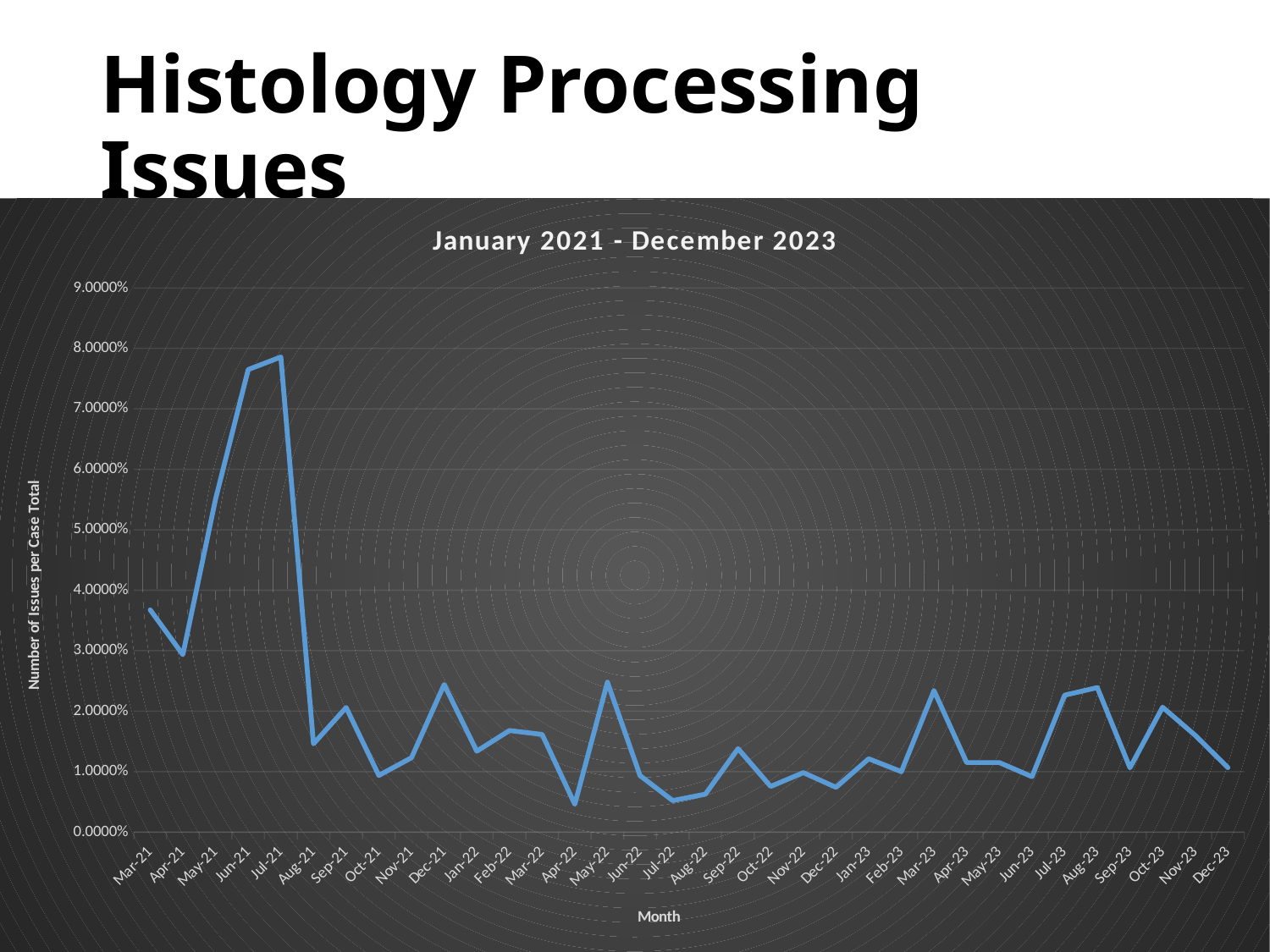
What kind of chart is shown on the slide? line chart How many months are plotted along the x axis? 34 Does the value rise or fall from Jul-21 to Aug-21? fall What is the title of the chart? January 2021 - December 2023 Is the value for Mar-21 greater or less than 3.0000%? greater Is the value for Jun-21 greater or less than 7.0000%? greater What is the label of the vertical axis? Number of Issues per Case Total Which is larger, the value for Mar-23 or the value for Apr-23? Mar-23 Which month has the highest value? Jul-21 Is the value for Apr-22 greater or less than 1.0000%? less Which is larger, the value for Jun-21 or the value for Aug-21? Jun-21